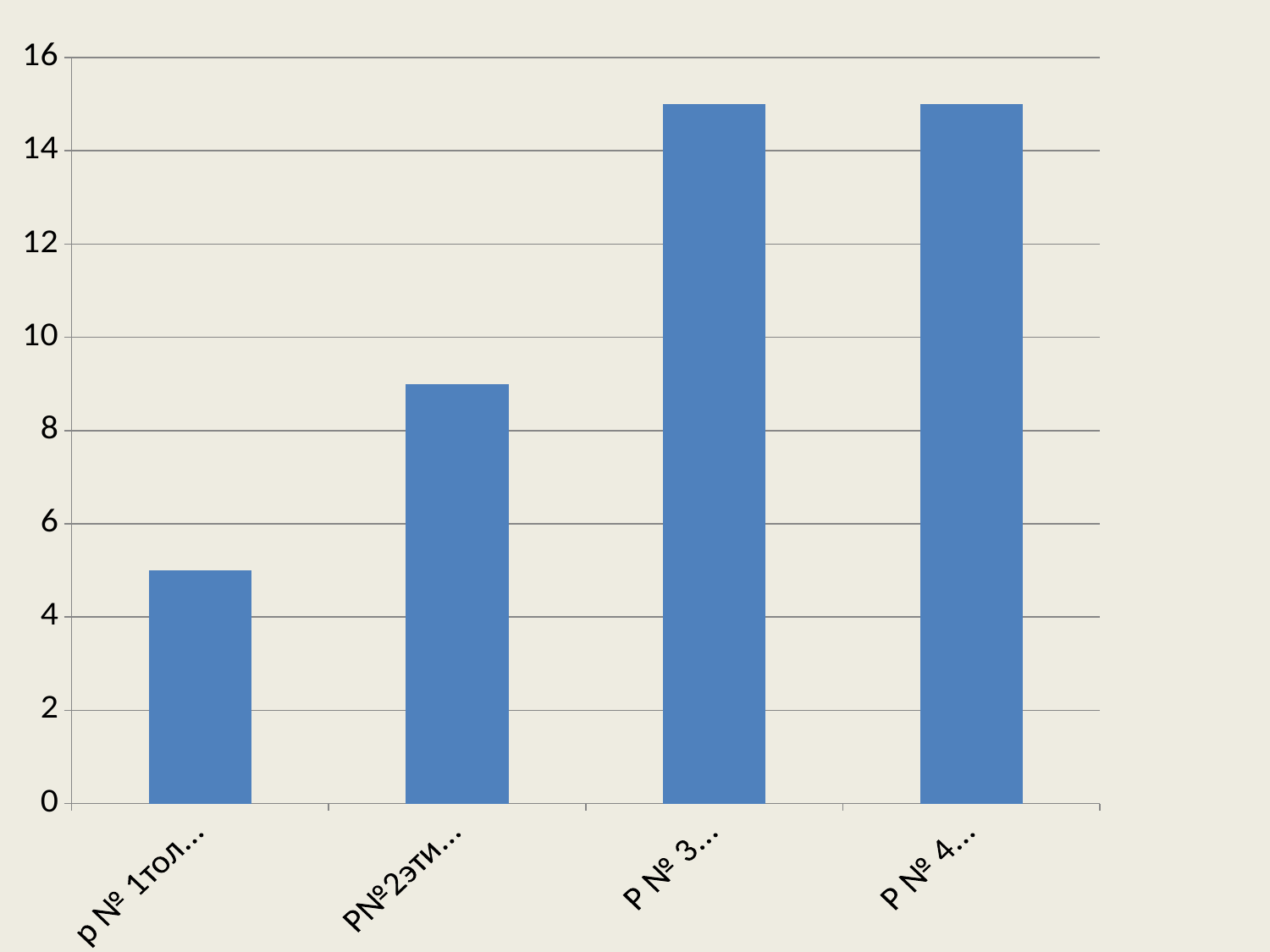
Is the value of the first bar (р № 1тол...) greater or less than 4? greater Which bar is the lowest in the chart? the first bar (р № 1тол...) Is the value of the fourth bar (Р № 4...) greater or less than 16? less Which is larger, the first bar (р № 1тол...) or the second bar (Р№2эти...)? the second bar (Р№2эти...) Do the bar values generally rise or fall from left to right across the chart? rise Is the value of the second bar (Р№2эти...) greater or less than 8? greater What kind of chart is shown on the slide? bar chart Which is larger, the second bar (Р№2эти...) or the third bar (Р № 3...)? the third bar (Р № 3...) How many bars (categories) are plotted in the chart? 4